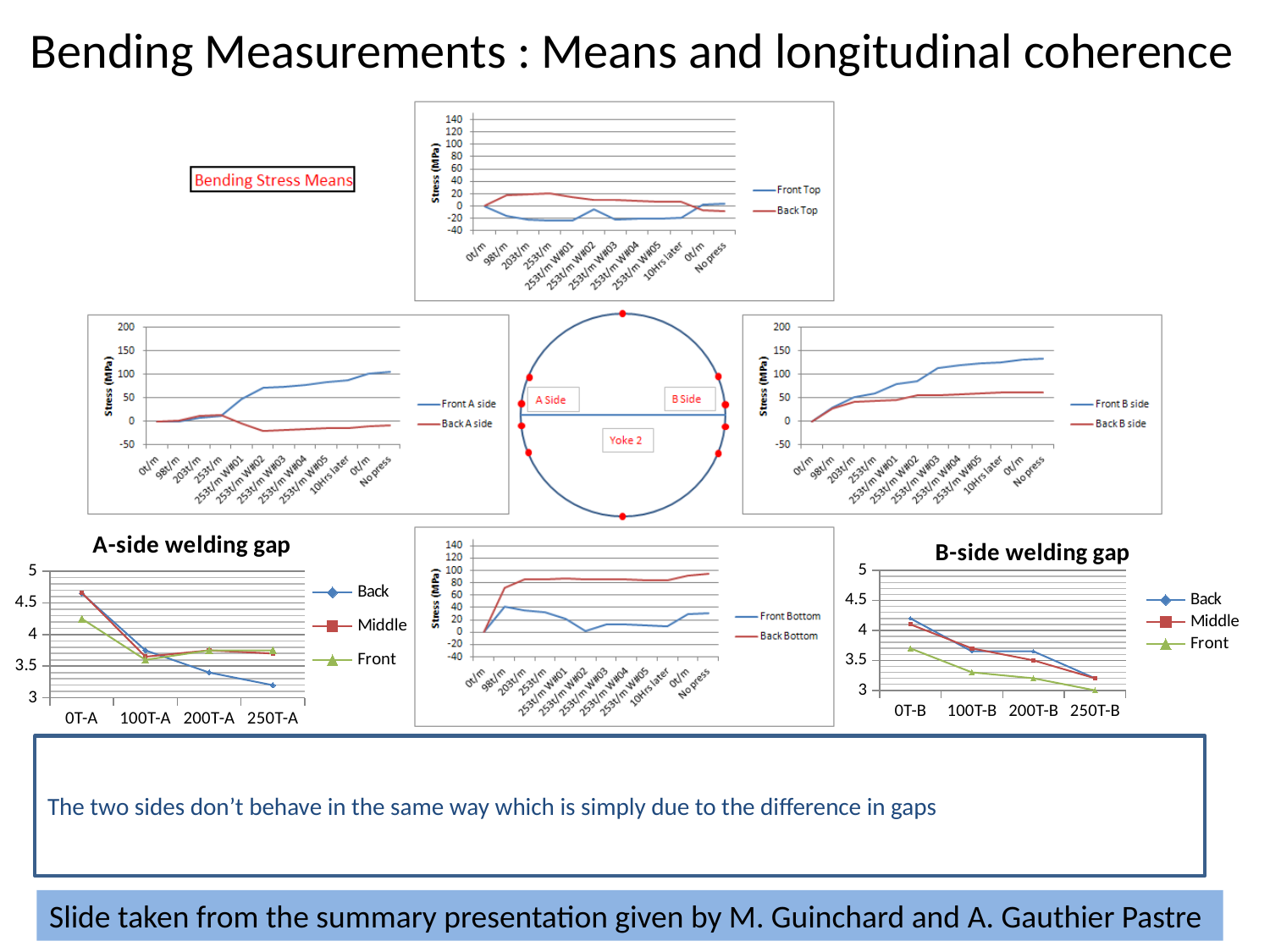
In the middle-left chart (Front A side / Back A side), is the Back A side value at "No press" greater or less than 0? less In the "B-side welding gap" chart, at which category is the Front series lowest? 250T-B How many categories are shown on the x axis of the "A-side welding gap" chart? 4 In the "B-side welding gap" chart, does the Back series rise or fall from 0T-B to 250T-B? fall How many series does the legend of the top chart (Front Top / Back Top) list? 2 In the "B-side welding gap" chart, is the Front value at 250T-B greater or less than 3.5? less In the "A-side welding gap" chart, which is larger at 0T-A, the Back value or the Front value? Back In the "A-side welding gap" chart, is the Back value at 250T-A greater or less than 3.5? less How many series does the legend of the "B-side welding gap" chart list? 3 What kind of chart is the "A-side welding gap" chart? line chart